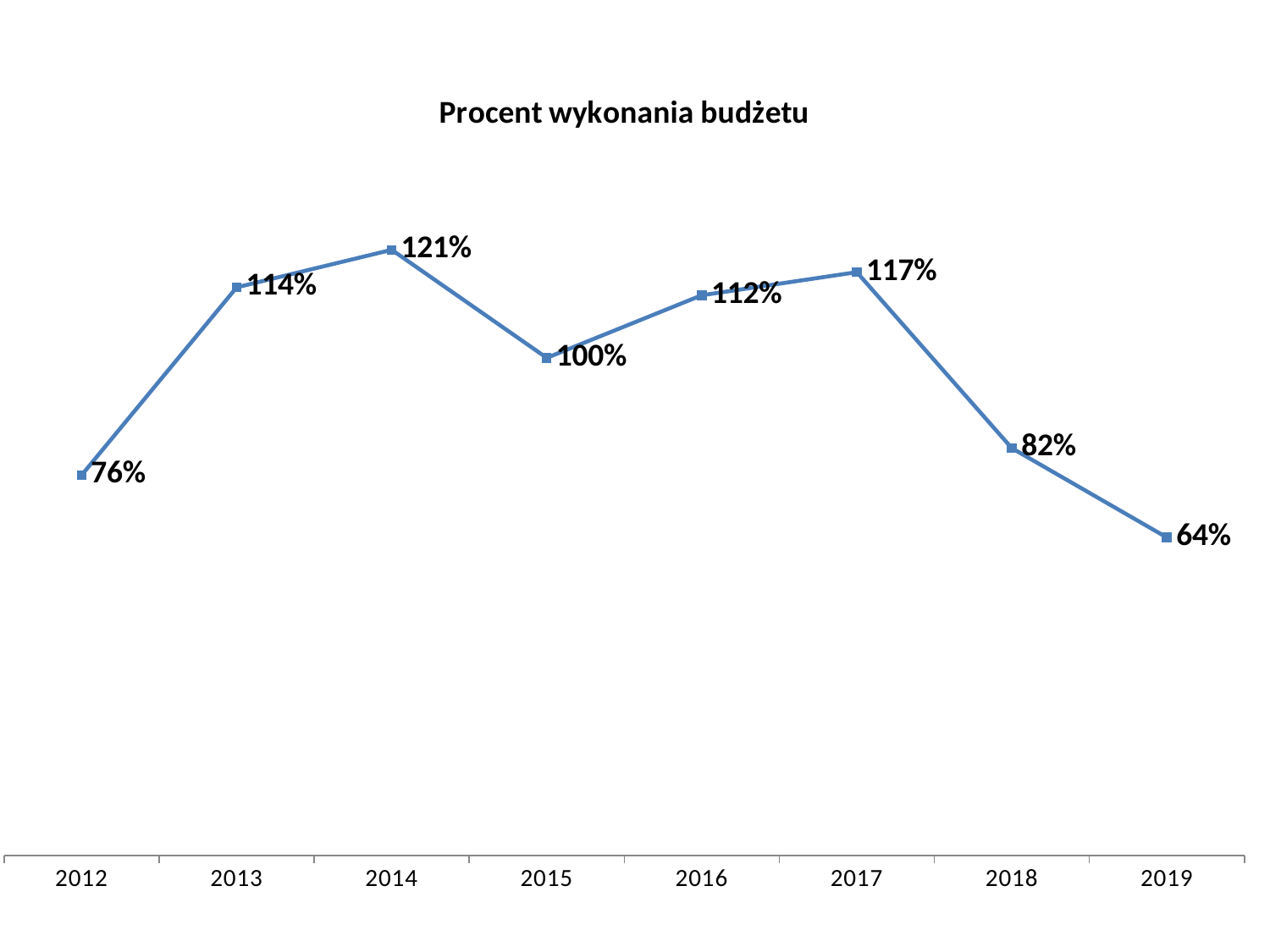
What is the title of the chart? Procent wykonania budżetu Do the values rise or fall from 2017 to 2019? fall What kind of chart is this? line chart What is the value for 2012? 76% Which year has the lowest value? 2019 How many years are plotted on the chart? 8 What is the difference between the values for 2017 and 2018? 35% What is the difference between the values for 2014 and 2015? 21% What is the value for 2019? 64% Which year has the highest value? 2014 Which is larger, the value for 2013 or the value for 2016? 2013 What is the value for 2014? 121%